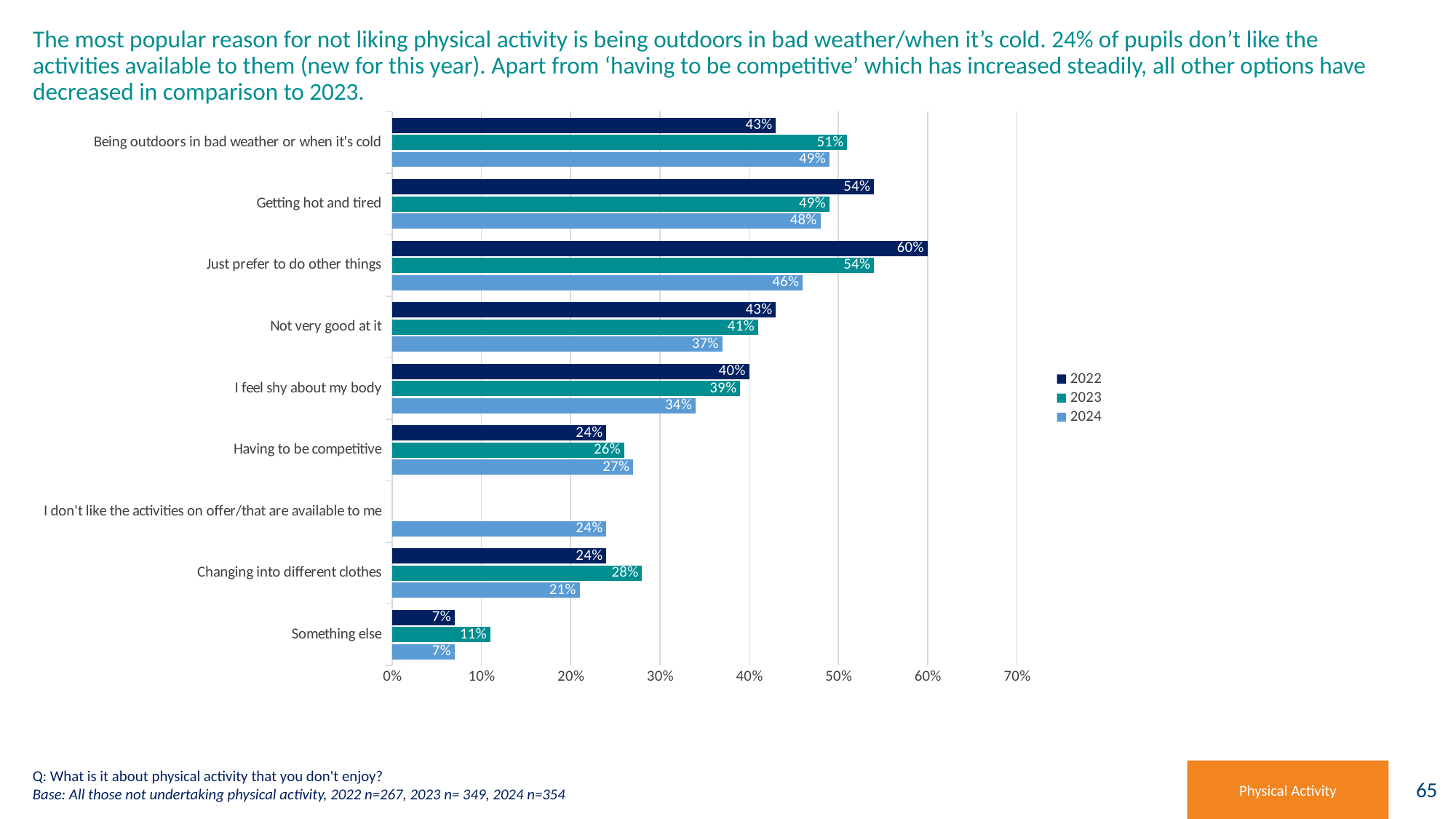
What is the 2024 value for 'Being outdoors in bad weather or when it's cold'? 49% Which is larger for 'Having to be competitive': the 2022 value or the 2024 value? 2024 What is the 2022 value for 'Just prefer to do other things'? 60% What is the 2023 value for 'Changing into different clothes'? 28% Which category has the highest 2024 value? Being outdoors in bad weather or when it's cold How many categories are shown on the y axis? 9 Which category has a value only for 2024? I don't like the activities on offer/that are available to me Which category has the lowest 2023 value? Something else Is the 2024 value for 'Not very good at it' greater or less than 40%? less What kind of chart is shown? bar chart What is the difference between the 2022 and 2024 values for 'Just prefer to do other things'? 14% How many series does the legend list? 3